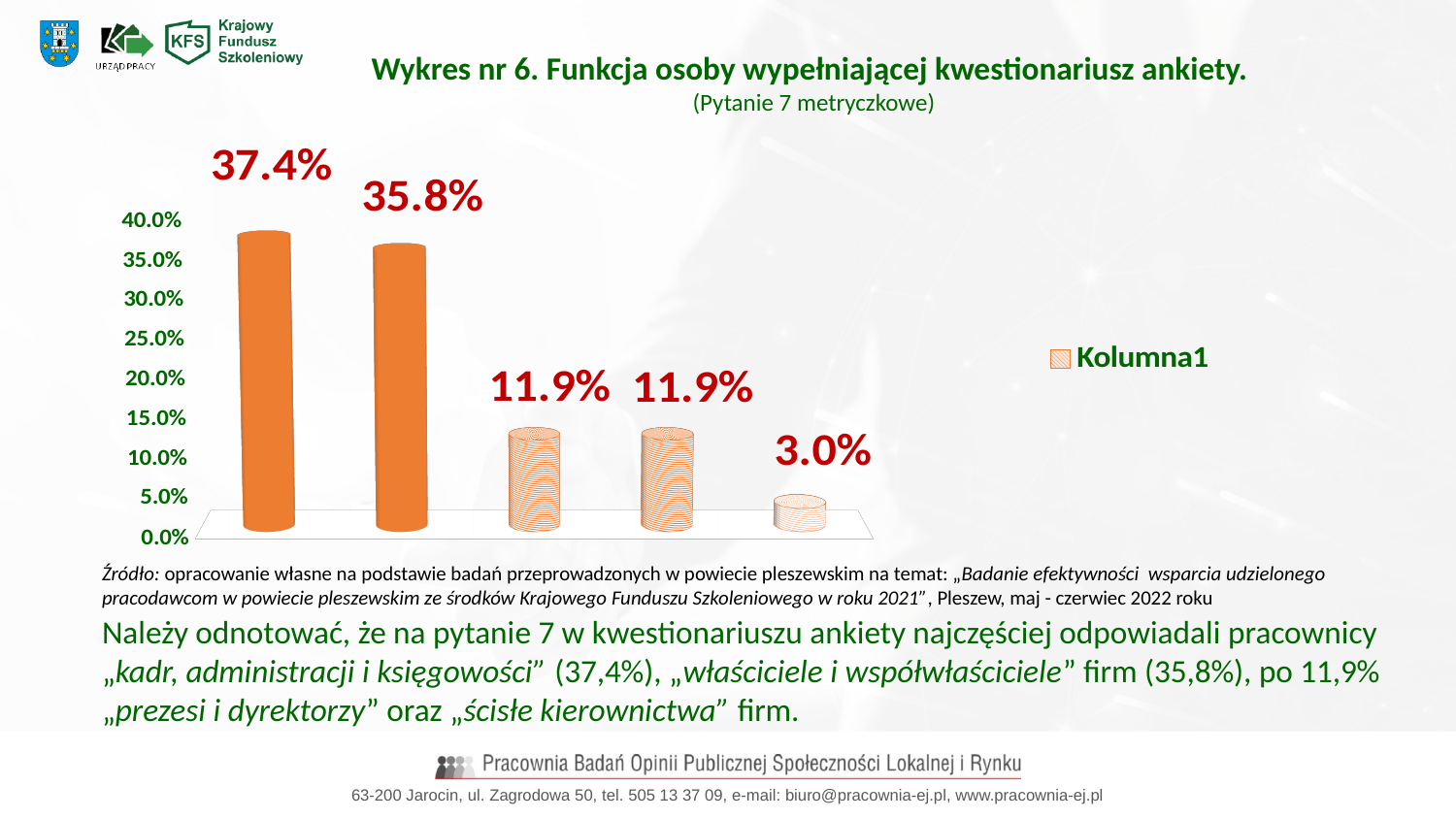
Which is larger, the value of the first bar or the value of the second bar? the first bar (37.4%) What is the difference between the first bar (37.4%) and the second bar (35.8%)? 1.6 percentage points What is the lowest value plotted in the chart? 3.0% What kind of chart is shown on the slide? bar chart How many bars are plotted in the chart? 5 What is the value shown on the rightmost bar of the chart? 3.0% What is the name of the series shown in the chart legend? Kolumna1 What is the highest value plotted in the chart? 37.4% What is the value shown on the leftmost bar of the chart? 37.4% How many series does the chart legend list? 1 What is the value shown on the second bar from the left? 35.8% Do the bar values rise or fall from left to right across the chart? fall